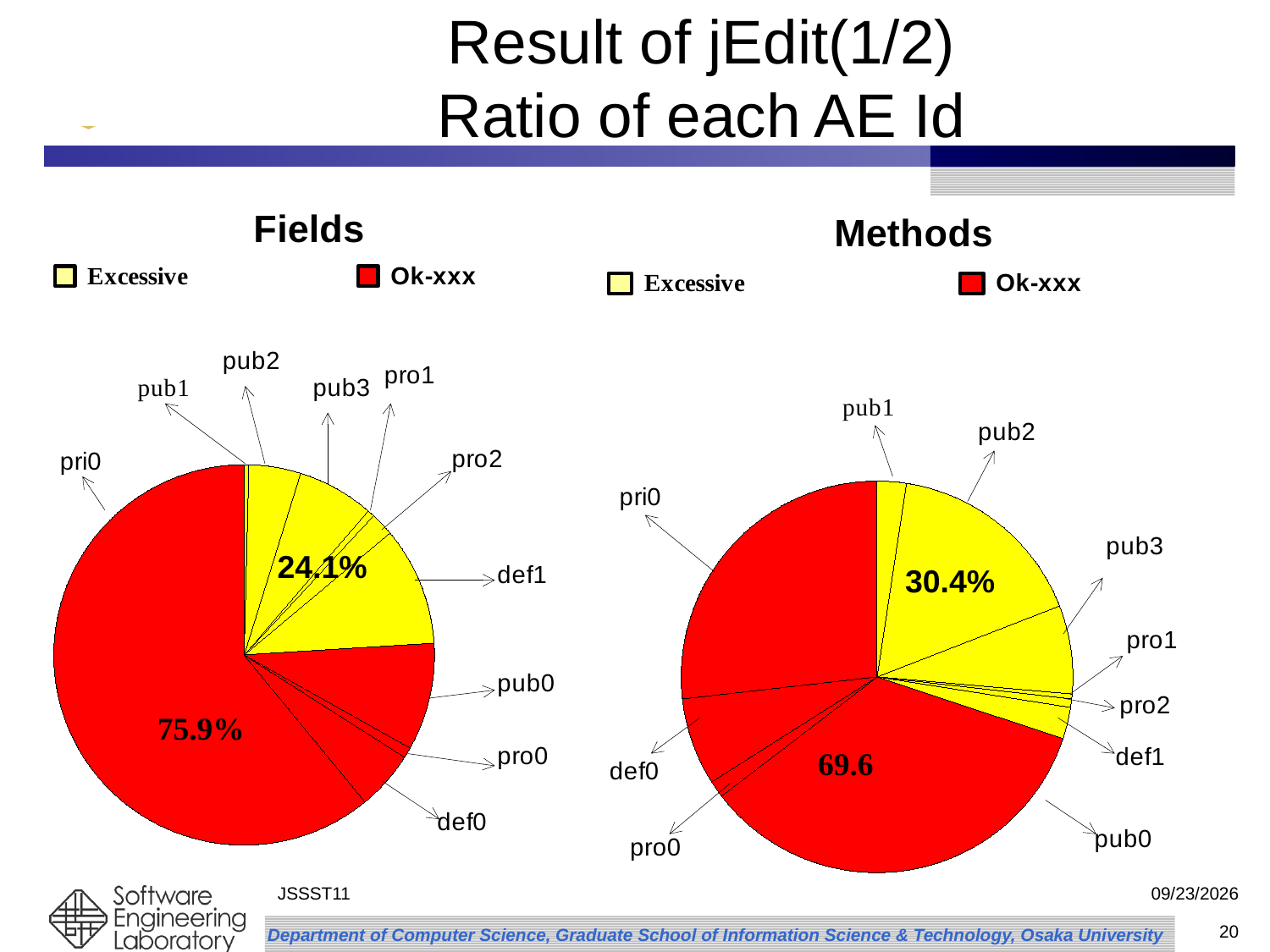
In the Methods chart, which labelled slice is the largest? pub0 Which chart has the larger Excessive share, Fields or Methods? Methods How many entries does the legend of the Methods chart list? 2 In the Fields chart, which colour represents Excessive? yellow In the Fields chart, which portion is larger, Excessive or Ok-xxx? Ok-xxx How many labelled slices does the Fields pie chart have? 10 In the Methods chart, what percentage is labelled on the Excessive (yellow) portion? 30.4% In the Fields chart, what percentage is labelled on the Ok-xxx (red) portion? 75.9% What kind of chart is the Fields chart? pie chart In the Methods chart, what value is labelled on the Ok-xxx (red) portion? 69.6 In the Fields chart, what is the difference between the Ok-xxx percentage and the Excessive percentage? 51.8% In the Fields chart, what percentage is labelled on the Excessive (yellow) portion? 24.1%